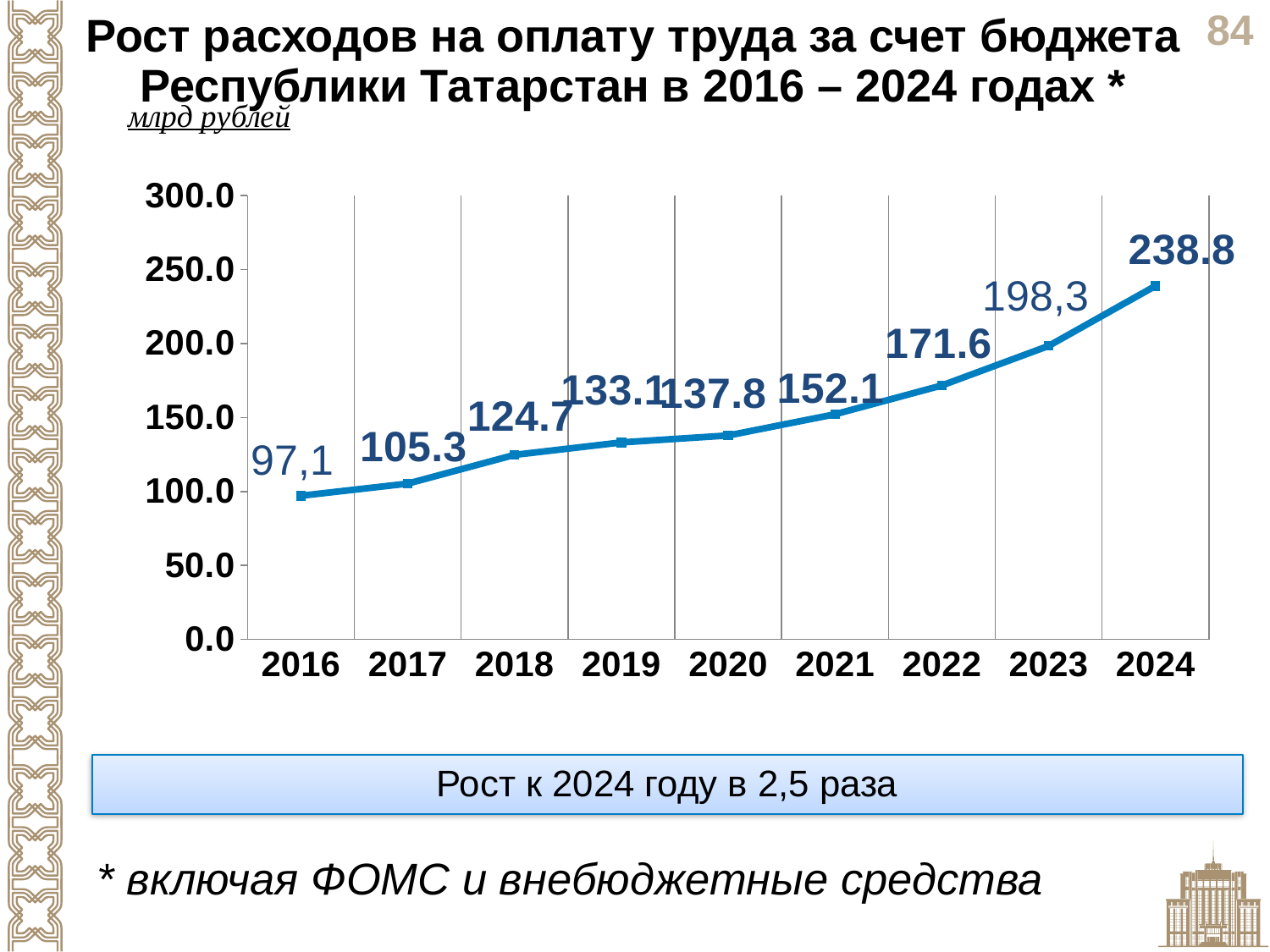
What is the value for 2016? 97,1 Which is larger, the value for 2019 or the value for 2020? 2020 What is the difference between the values for 2022 and 2021? 19.5 Which year has the lowest value? 2016 Do the values rise or fall from 2016 to 2024? rise What is the value for 2024? 238.8 What is the difference between the values for 2024 and 2023? 40.5 Which year has the highest value? 2024 What is the value for 2021? 152.1 How many years are plotted on the chart? 9 What is the value for 2023? 198,3 What kind of chart is shown on the slide? line chart